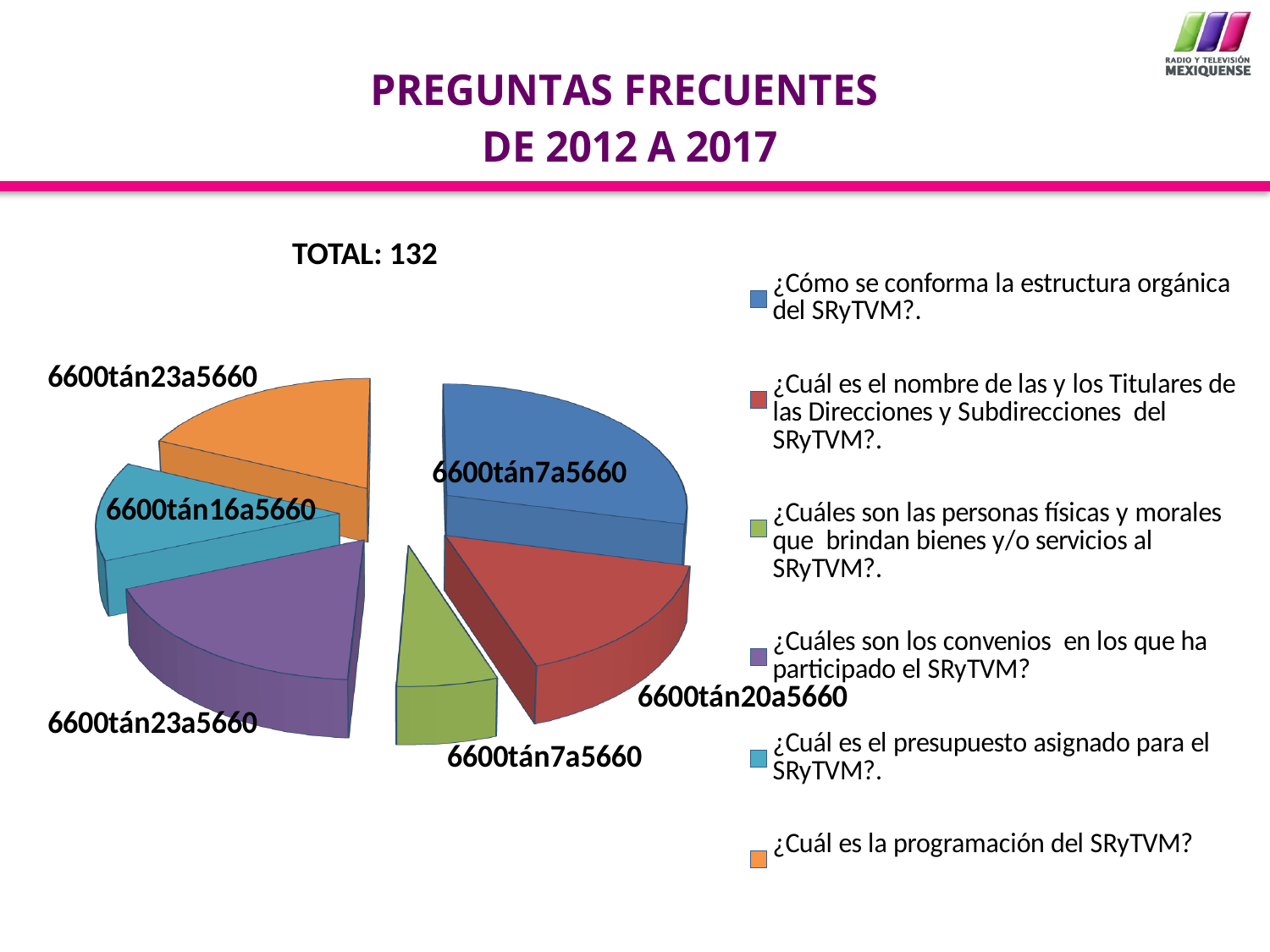
What total is printed above the pie chart? TOTAL: 132 Which slice is larger: '¿Cuál es la programación del SRyTVM?' or '¿Cuáles son las personas físicas y morales que brindan bienes y/o servicios al SRyTVM?.'? ¿Cuál es la programación del SRyTVM? What kind of chart is shown on the slide? pie chart Which slice is larger: '¿Cuáles son los convenios en los que ha participado el SRyTVM?' or '¿Cuál es el presupuesto asignado para el SRyTVM?.'? ¿Cuáles son los convenios en los que ha participado el SRyTVM? Which legend entry has the smallest slice in the pie chart? ¿Cuáles son las personas físicas y morales que brindan bienes y/o servicios al SRyTVM?. How many slices does the pie chart have? 6 What is the title of the slide containing the pie chart? PREGUNTAS FRECUENTES DE 2012 A 2017 Which slice is larger: '¿Cuál es el nombre de las y los Titulares de las Direcciones y Subdirecciones del SRyTVM?.' or '¿Cuáles son las personas físicas y morales que brindan bienes y/o servicios al SRyTVM?.'? ¿Cuál es el nombre de las y los Titulares de las Direcciones y Subdirecciones del SRyTVM?. How many entries does the legend of the pie chart list? 6